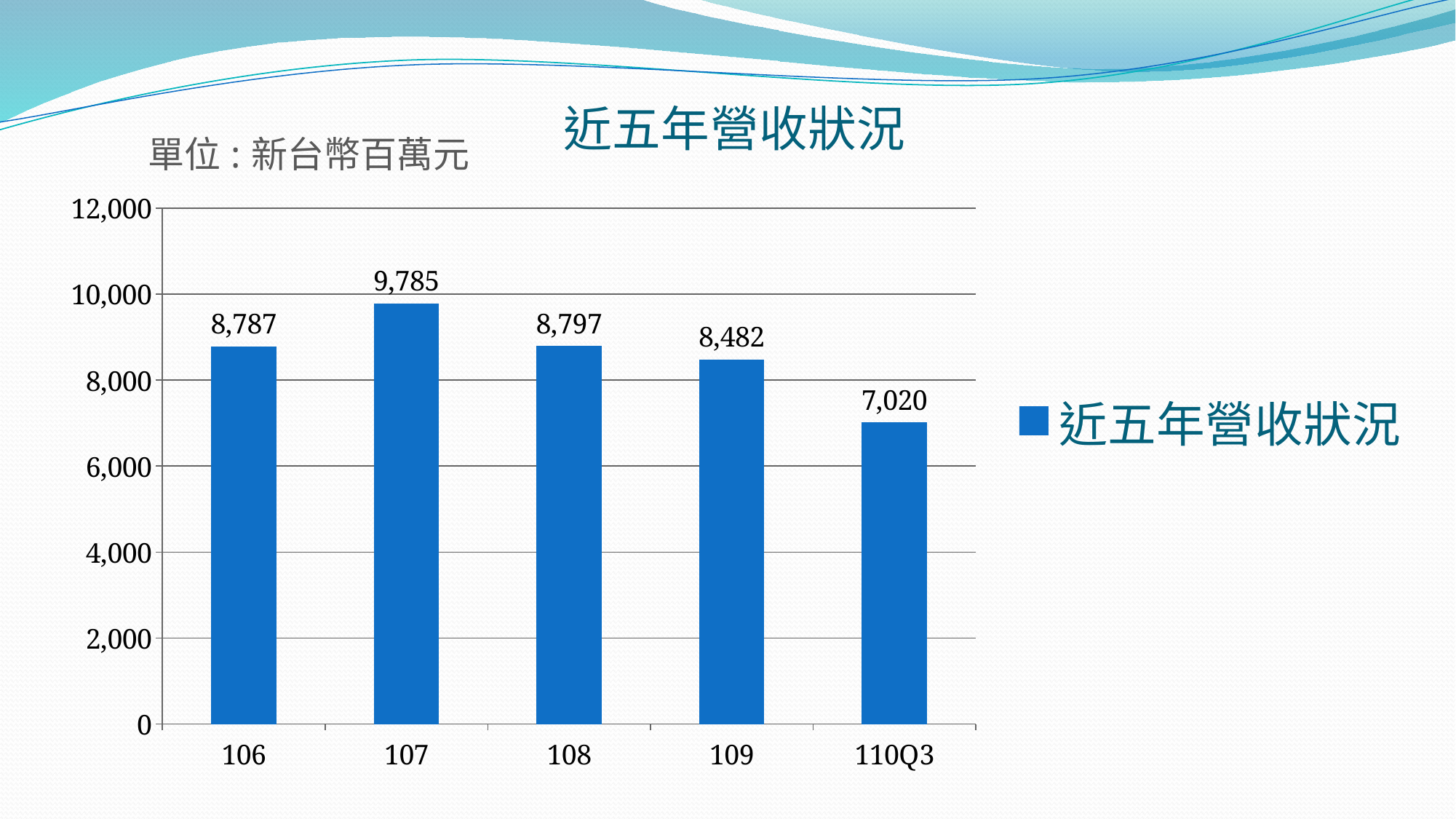
Which category has the lowest value? 110Q3 What is the title of the chart? 近五年營收狀況 How many series does the legend list? 1 Which is larger, the value for 109 or the value for 110Q3? 109 What is the value for 107? 9,785 What kind of chart is shown? bar chart What is the value for 110Q3? 7,020 How many categories are shown on the x axis? 5 What is the difference between the values for 107 and 109? 1,303 Is the value for 108 greater or less than 8,000? greater What is the value for 106? 8,787 Which category has the highest value? 107